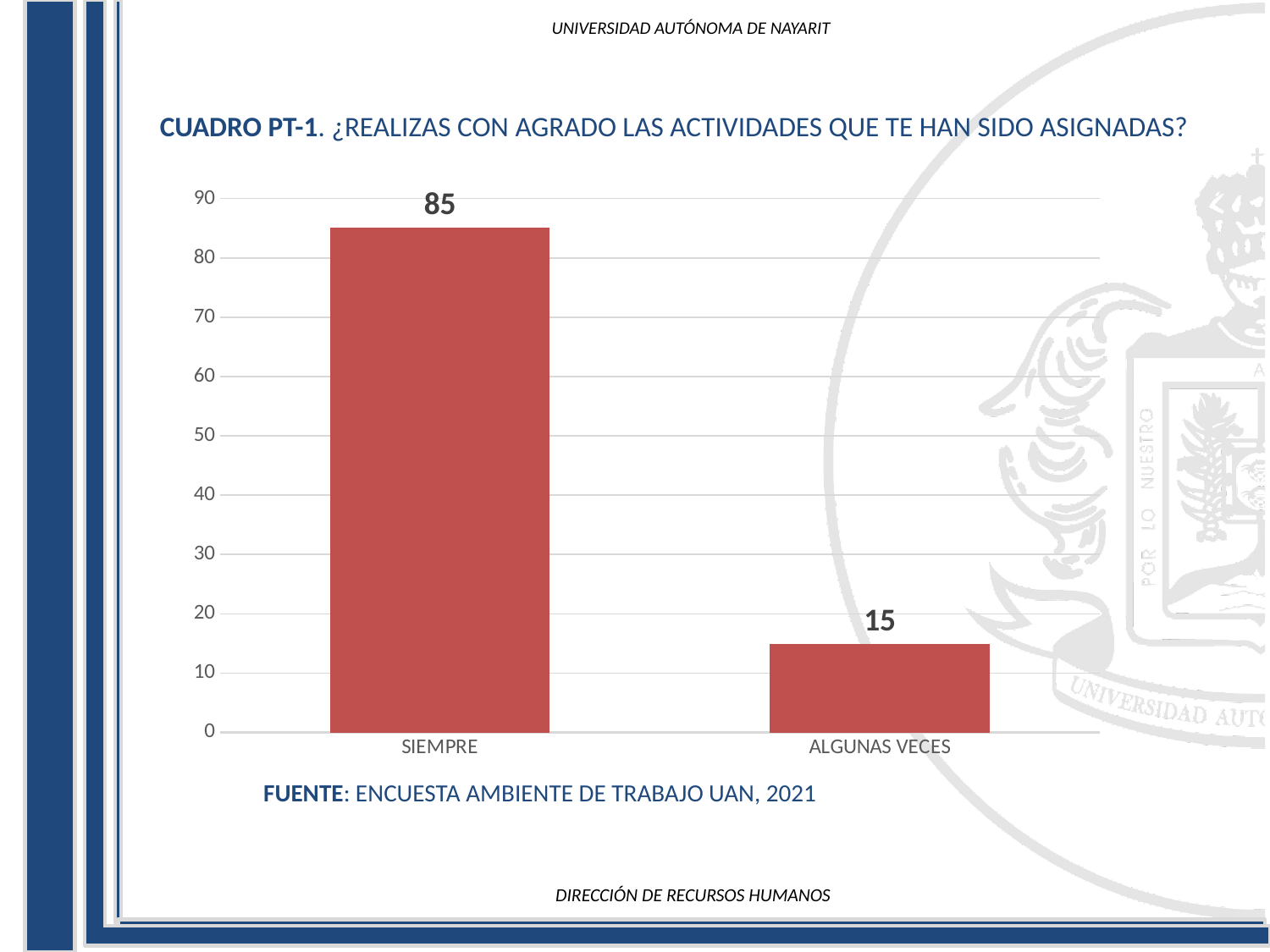
Which is larger, the value for SIEMPRE or the value for ALGUNAS VECES? SIEMPRE What is the source cited below the chart? ENCUESTA AMBIENTE DE TRABAJO UAN, 2021 Which category has the highest value? SIEMPRE What is the difference between the values for SIEMPRE and ALGUNAS VECES? 70 How many categories are shown on the x axis? 2 Is the value for SIEMPRE greater or less than 80? greater What is the highest value shown on the y axis? 90 Is the value for ALGUNAS VECES greater or less than 20? less Which category has the lowest value? ALGUNAS VECES What is the value for ALGUNAS VECES? 15 What is the value for SIEMPRE? 85 What kind of chart is shown on the slide? bar chart